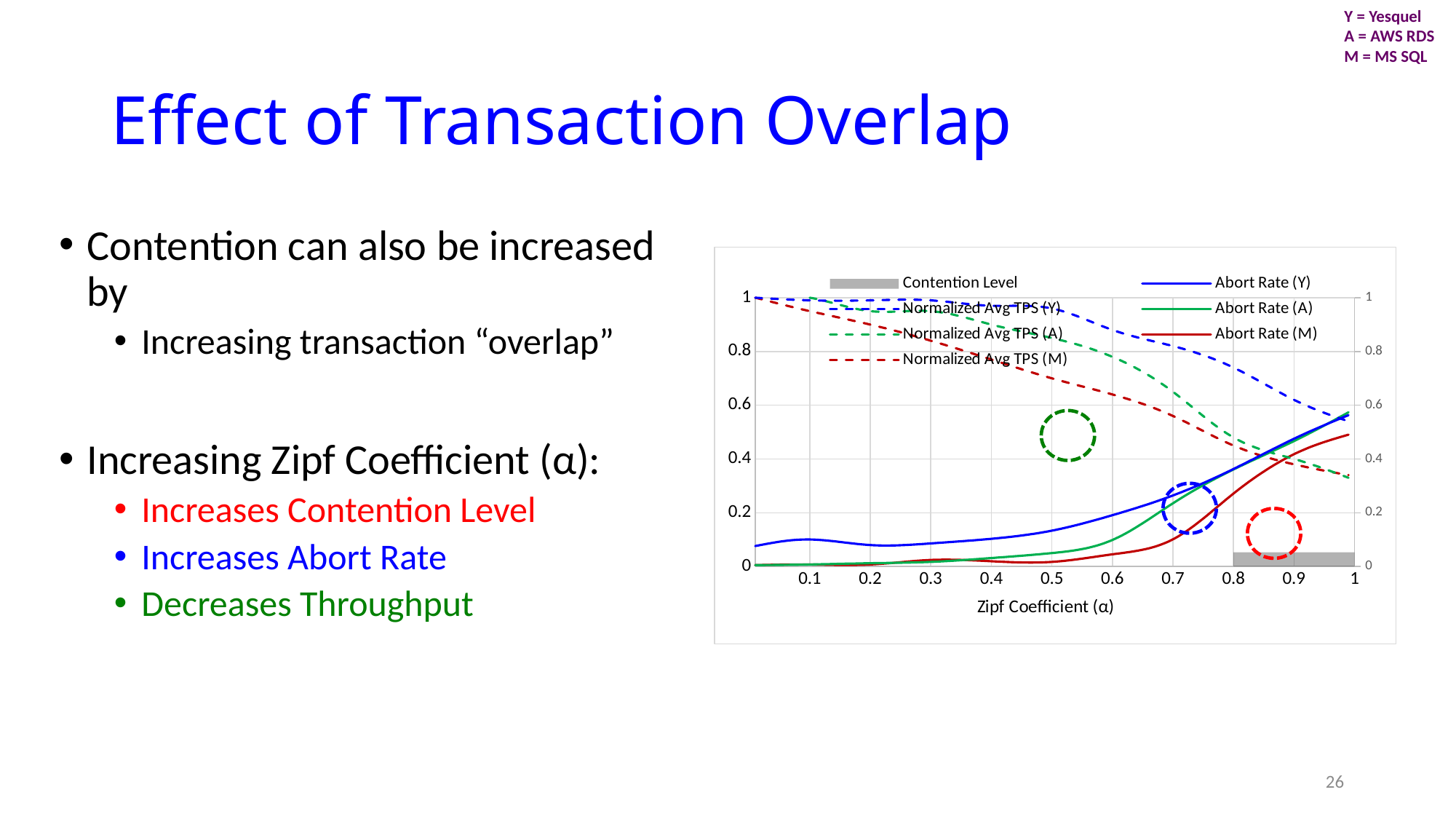
Which legend entry is drawn as a grey bar rather than a line? Contention Level Is the value of Abort Rate (Y) at a Zipf Coefficient of 0.5 greater or less than 0.2? less At a Zipf Coefficient of 0.5, which is larger: Abort Rate (Y) or Abort Rate (A)? Abort Rate (Y) How many series does the chart legend list? 7 What is the title of the x axis of the chart? Zipf Coefficient (α) What kind of chart is shown on the slide? line chart Is the value of Normalized Avg TPS (A) at a Zipf Coefficient of 1 greater or less than 0.4? less At a Zipf Coefficient of 1, which is larger: Normalized Avg TPS (Y) or Normalized Avg TPS (A)? Normalized Avg TPS (Y) Is the value of Normalized Avg TPS (Y) at a Zipf Coefficient of 0.5 greater or less than 0.8? greater Does the Normalized Avg TPS (M) series rise or fall as the Zipf Coefficient increases from 0 to 1? fall Does the Abort Rate (A) series rise or fall as the Zipf Coefficient increases from 0 to 1? rise